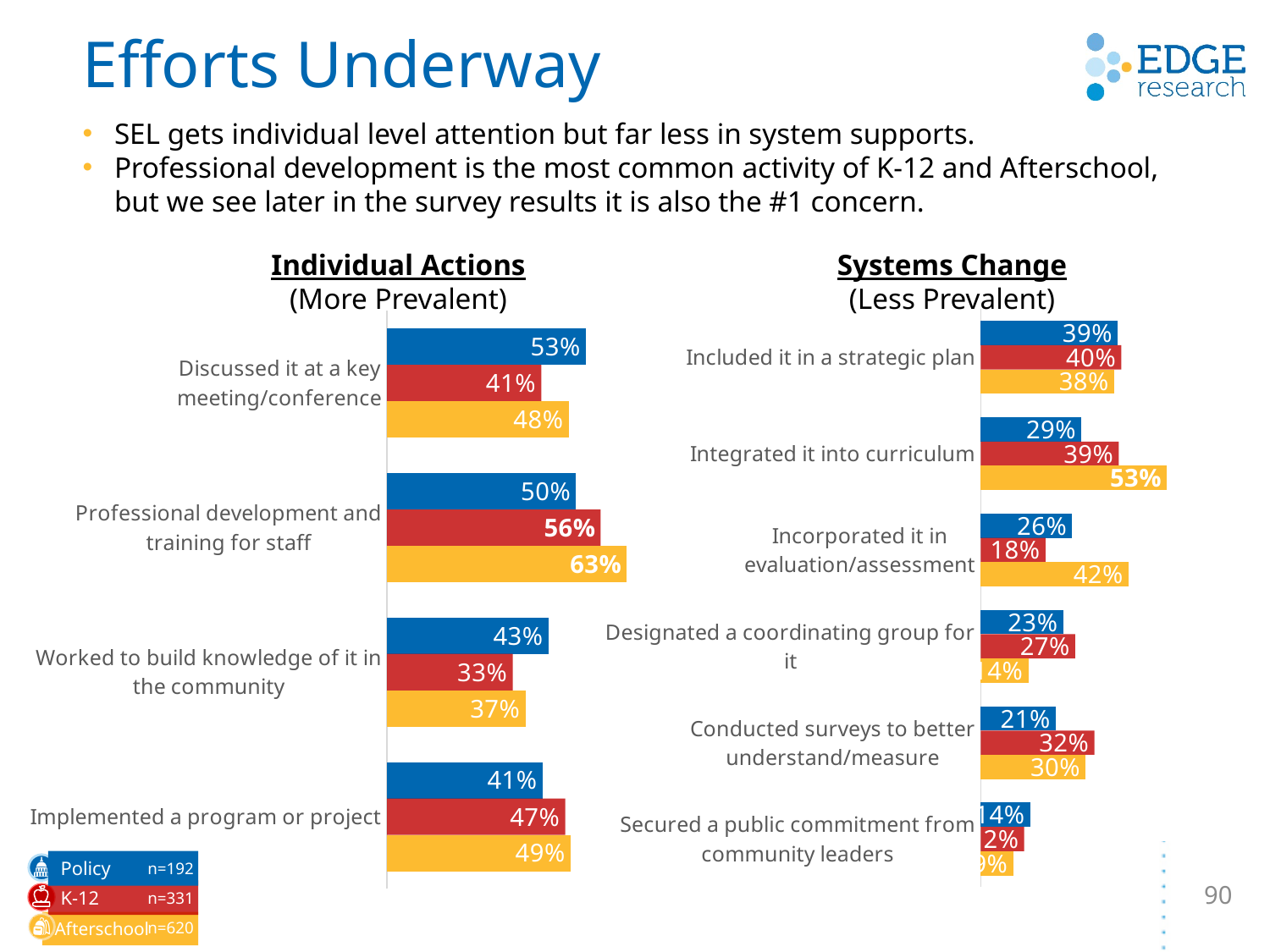
In the Systems Change chart, what is the Afterschool value for 'Integrated it into curriculum'? 53% How many categories does the Systems Change chart show? 6 In the Individual Actions chart, what is the Policy value for 'Discussed it at a key meeting/conference'? 53% In the Individual Actions chart, which category has the highest Afterschool value? Professional development and training for staff In the Individual Actions chart, what is the difference between the Afterschool and Policy values for 'Professional development and training for staff'? 13 percentage points In the Individual Actions chart, what is the Afterschool value for 'Professional development and training for staff'? 63% In the Individual Actions chart, which category has the lowest K-12 value? Worked to build knowledge of it in the community What type of chart is the Individual Actions chart? Bar chart In the Systems Change chart, what is the difference between the Afterschool and K-12 values for 'Incorporated it in evaluation/assessment'? 24 percentage points In the Systems Change chart, is the Policy value or the Afterschool value larger for 'Integrated it into curriculum'? Afterschool How many series does the legend list? 3 In the Systems Change chart, what is the K-12 value for 'Incorporated it in evaluation/assessment'? 18%